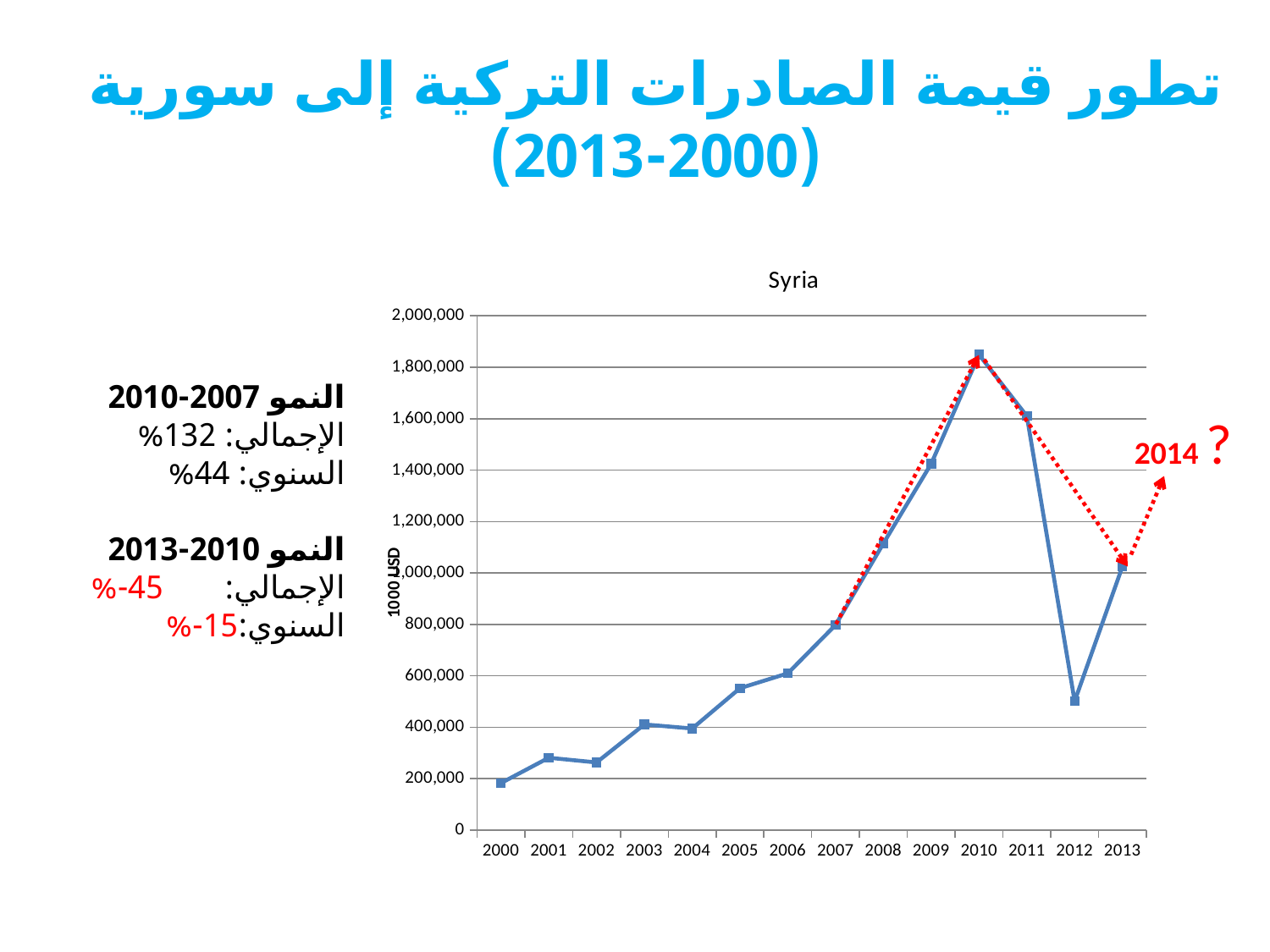
What is the title of the chart? Syria Is the value for 2007 greater or less than 1,000,000? less What kind of chart is shown on the slide? line chart Which year has the larger value, 2011 or 2013? 2011 What is the label on the vertical axis of the chart? 1000 USD Do the values rise or fall from 2010 to 2012? fall In which year does the line have its lowest value? 2000 Is the value for 2012 greater or less than 600,000? less How many years are plotted on the x axis of the chart? 14 In which year does the line reach its highest value? 2010 Which year has the larger value, 2009 or 2012? 2009 Is the value for 2010 greater or less than 1,800,000? greater